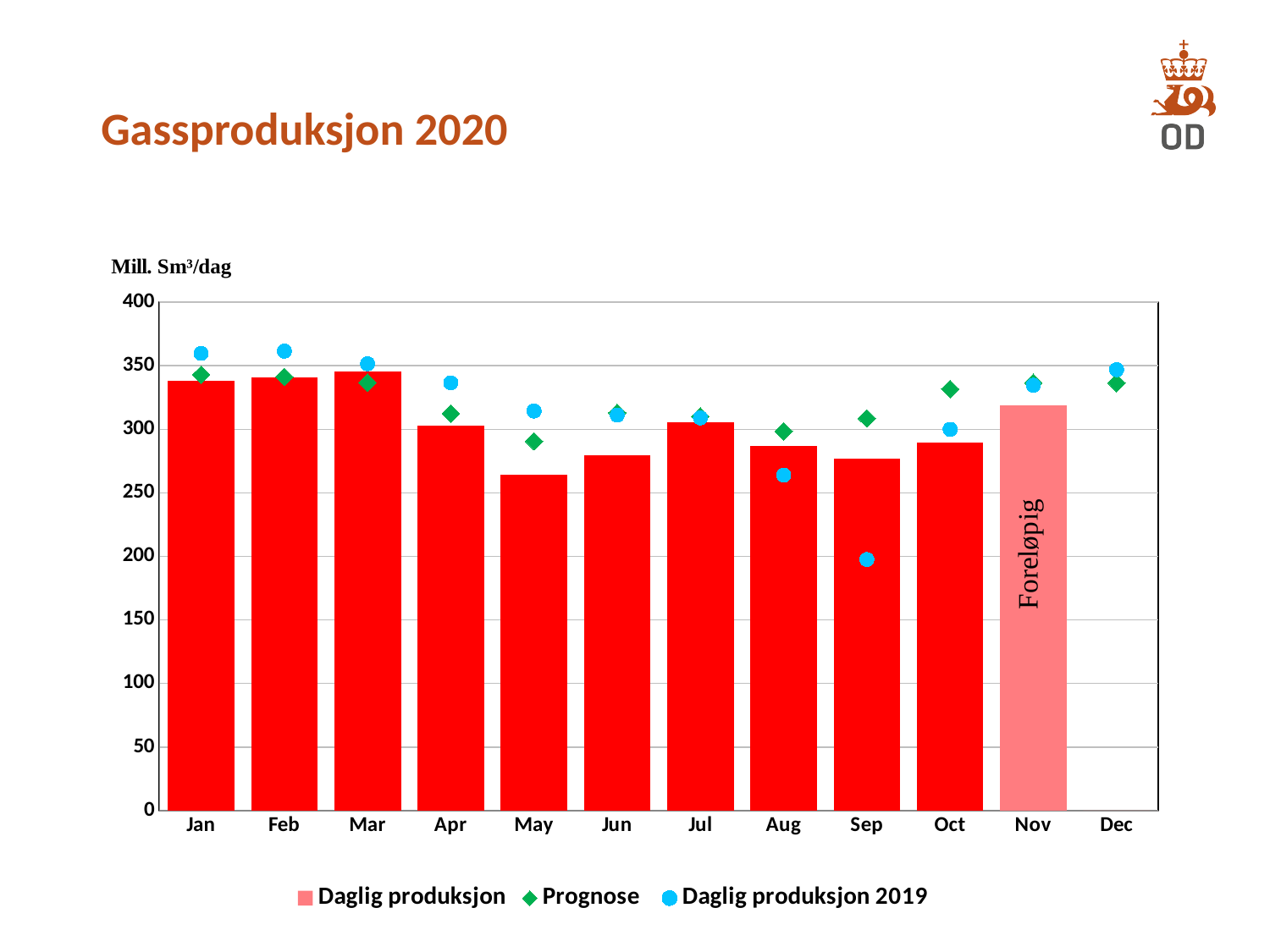
Is the Daglig produksjon 2019 value for Sep greater or less than 250? less Which month has the lowest Daglig produksjon 2019 value? Sep Which month has the lowest Daglig produksjon bar? May How many series does the legend list? 3 How many months are labelled on the x axis? 12 Do the Daglig produksjon bars rise or fall from Jan to May? fall Which is larger, the Daglig produksjon bar for Jan or for May? Jan What is the title of the chart? Gassproduksjon 2020 Which month has the lowest Prognose value? May Is the Daglig produksjon value for Nov greater or less than 300? greater What kind of chart is shown on the slide? bar chart Is the Daglig produksjon value for May greater or less than 300? less